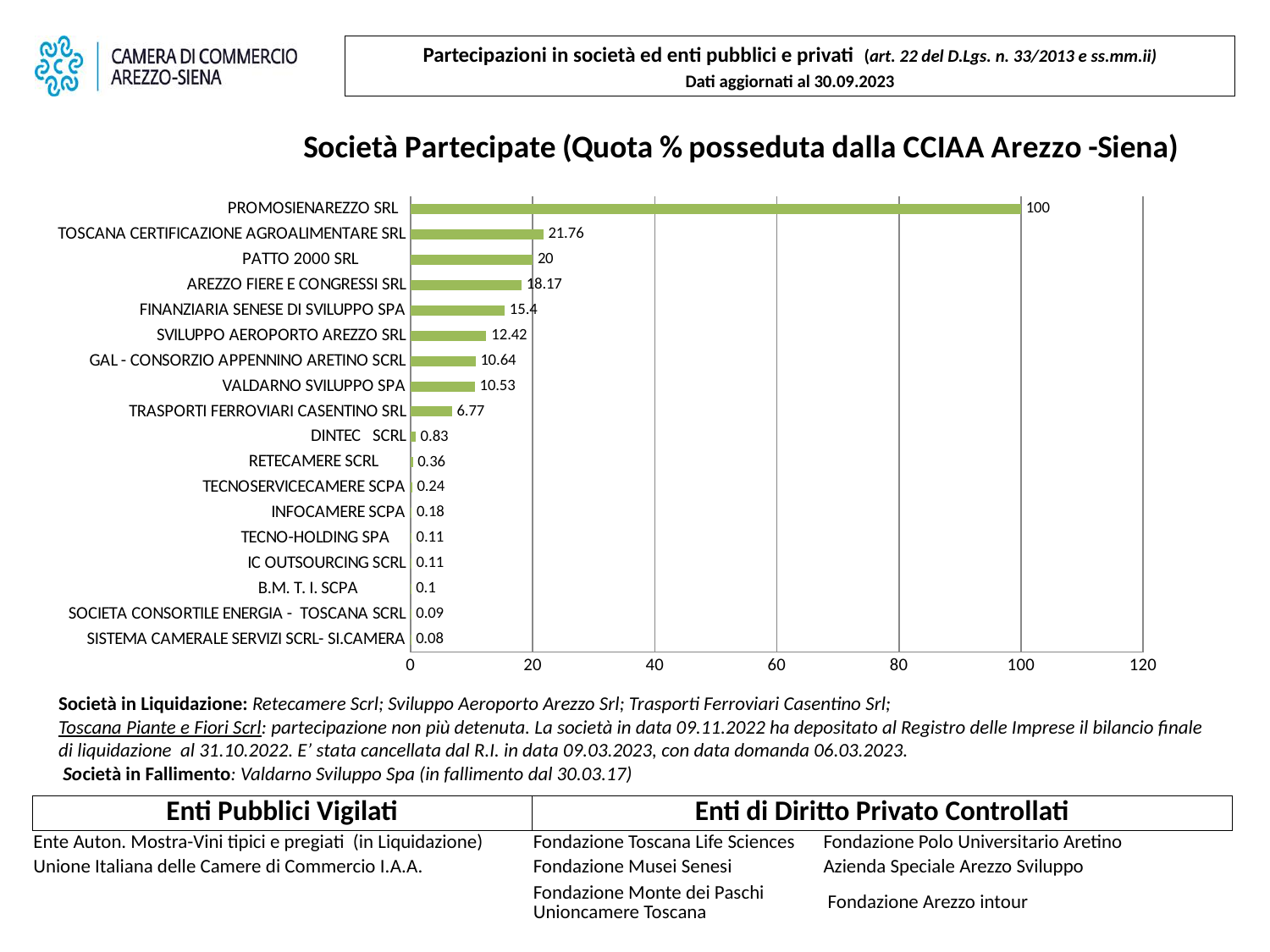
How many companies (categories) are plotted in the chart? 18 Which has a larger value, GAL - CONSORZIO APPENNINO ARETINO SCRL or VALDARNO SVILUPPO SPA? GAL - CONSORZIO APPENNINO ARETINO SCRL What is the value for TRASPORTI FERROVIARI CASENTINO SRL? 6.77 What type of chart is shown on the slide? bar chart Which company has the lowest value in the chart? SISTEMA CAMERALE SERVIZI SCRL- SI.CAMERA What is the value for TOSCANA CERTIFICAZIONE AGROALIMENTARE SRL? 21.76 Do the values rise or fall going from the top bar to the bottom bar of the chart? fall What is the title of the chart? Società Partecipate (Quota % posseduta dalla CCIAA Arezzo -Siena) What is the value for PROMOSIENAREZZO SRL? 100 What is the difference between the values for PROMOSIENAREZZO SRL and TOSCANA CERTIFICAZIONE AGROALIMENTARE SRL? 78.24 Which company has the highest value in the chart? PROMOSIENAREZZO SRL What is the value for AREZZO FIERE E CONGRESSI SRL? 18.17